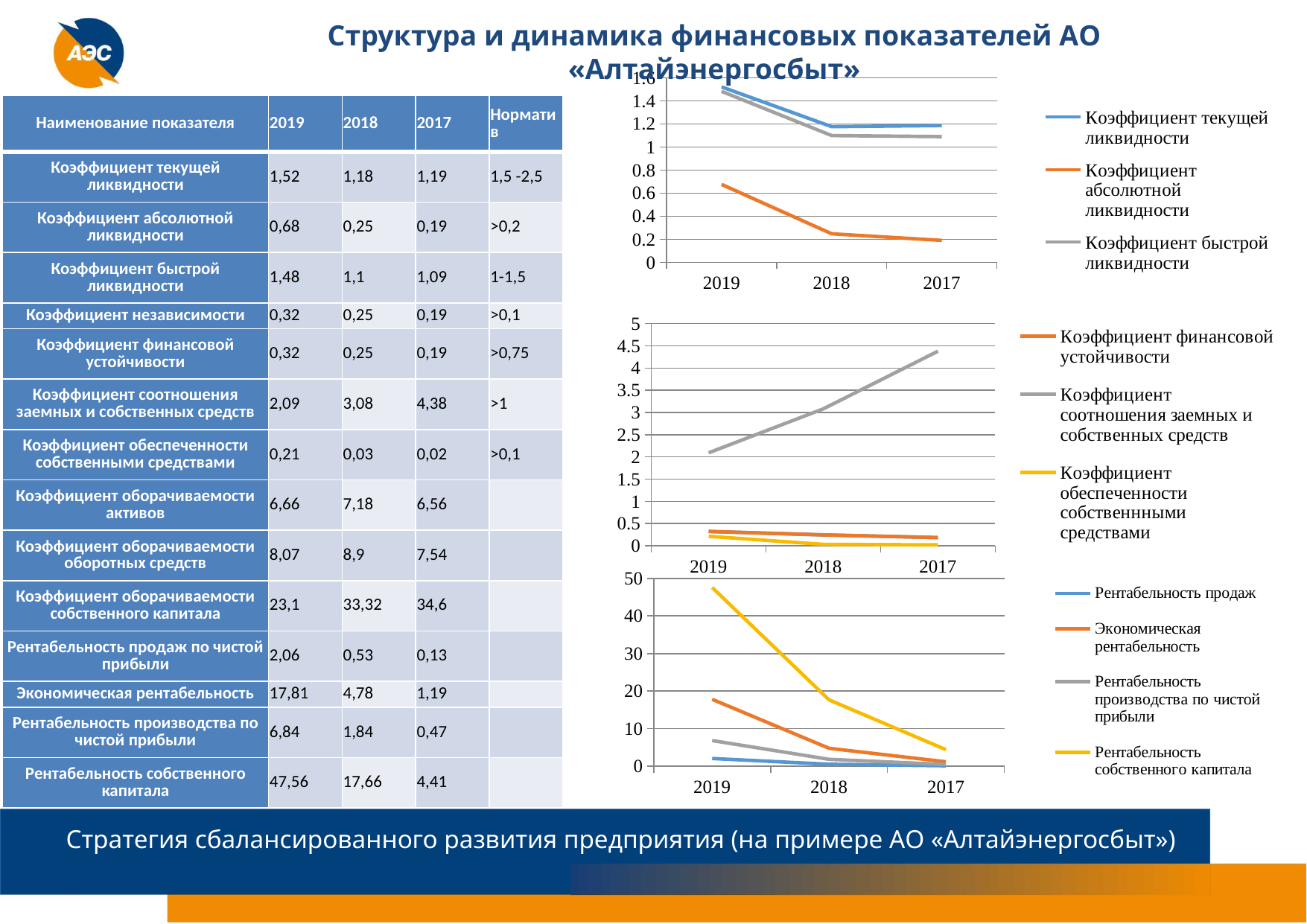
In the middle chart, is the value for Коэффициент соотношения заемных и собственных средств in 2017 greater or less than 4? greater In the top chart (liquidity coefficients), does Коэффициент текущей ликвидности rise or fall from 2019 to 2018? fall How many years are shown on the x axis of the top chart (liquidity coefficients)? 3 In the middle chart, does Коэффициент соотношения заемных и собственных средств rise or fall from 2019 to 2017? rise How many series does the legend of the bottom chart (profitability) list? 4 In the bottom chart (profitability), is the value for Рентабельность собственного капитала in 2019 greater or less than 40? greater How many series does the legend of the top chart (liquidity coefficients) list? 3 What kind of chart is the top chart on the right (liquidity coefficients)? line chart In the top chart (liquidity coefficients), which series has the lowest values in every year? Коэффициент абсолютной ликвидности In the bottom chart (profitability), which series has the highest value in 2019? Рентабельность собственного капитала How many series does the legend of the middle chart (financial stability coefficients) list? 3 In the top chart (liquidity coefficients), is the value for Коэффициент абсолютной ликвидности in 2019 greater or less than 0.6? greater